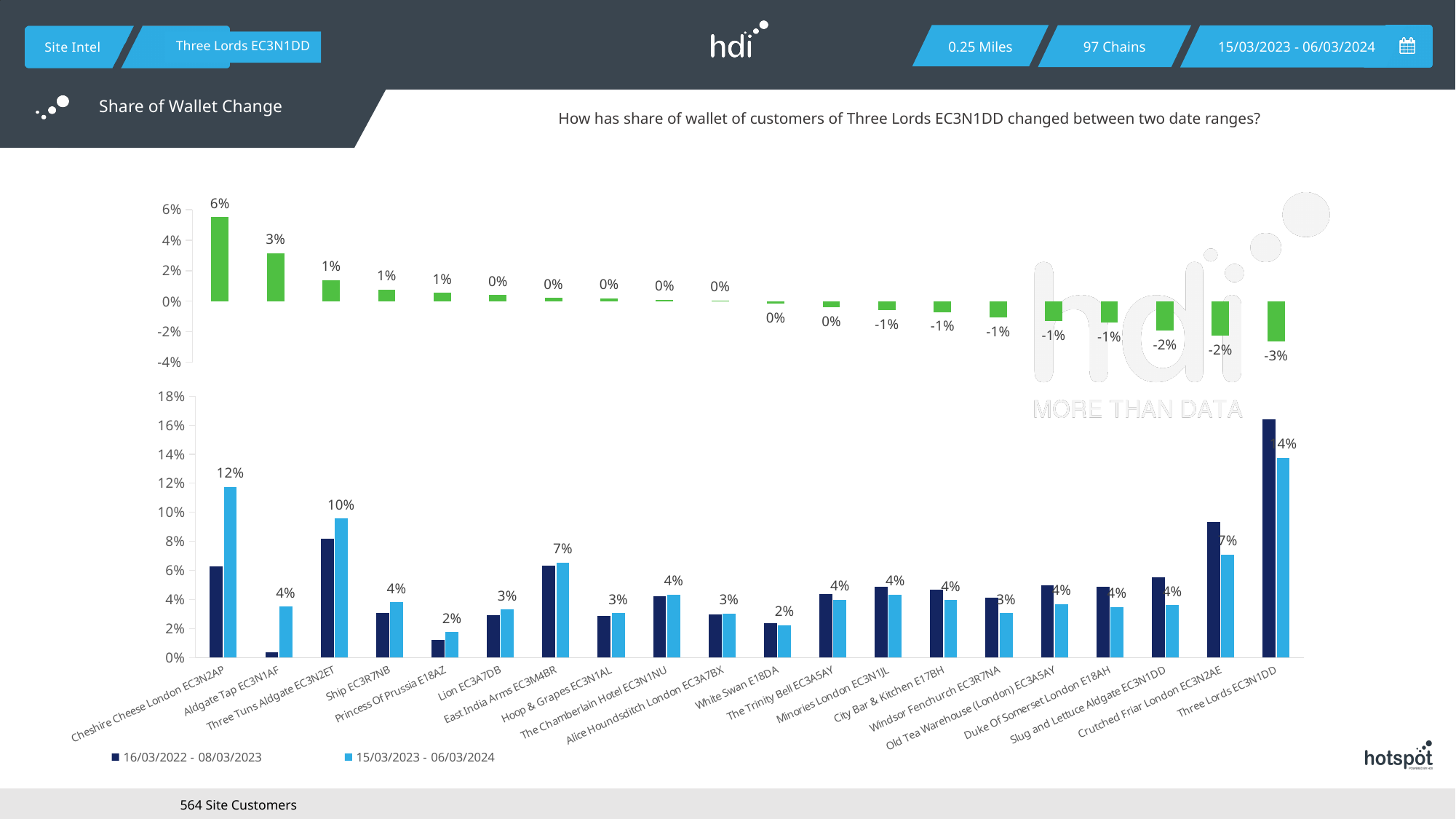
In the top chart, which venue has the lowest share of wallet change? Three Lords EC3N1DD In the top chart, what is the share of wallet change for Three Lords EC3N1DD? -3% In the bottom chart, is the 16/03/2022 - 08/03/2023 value for Three Lords EC3N1DD greater or less than 14%? greater In the bottom chart, what is the 15/03/2023 - 06/03/2024 value for Three Tuns Aldgate EC3N2ET? 10% In the top chart, what is the share of wallet change for Aldgate Tap EC3N1AF? 3% In the top chart, what is the share of wallet change for Cheshire Cheese London EC3N2AP? 6% In the bottom chart, which has the larger 15/03/2023 - 06/03/2024 value: Cheshire Cheese London EC3N2AP or Three Tuns Aldgate EC3N2ET? Cheshire Cheese London EC3N2AP In the bottom chart, what is the difference between the 15/03/2023 - 06/03/2024 values for Three Lords EC3N1DD and Cheshire Cheese London EC3N2AP? 2% In the bottom chart, how many venues are shown on the x axis? 20 In the bottom chart, how many series does the legend list? 2 In the top chart, which venue has the highest share of wallet change? Cheshire Cheese London EC3N2AP What kind of chart is the bottom chart? Bar chart